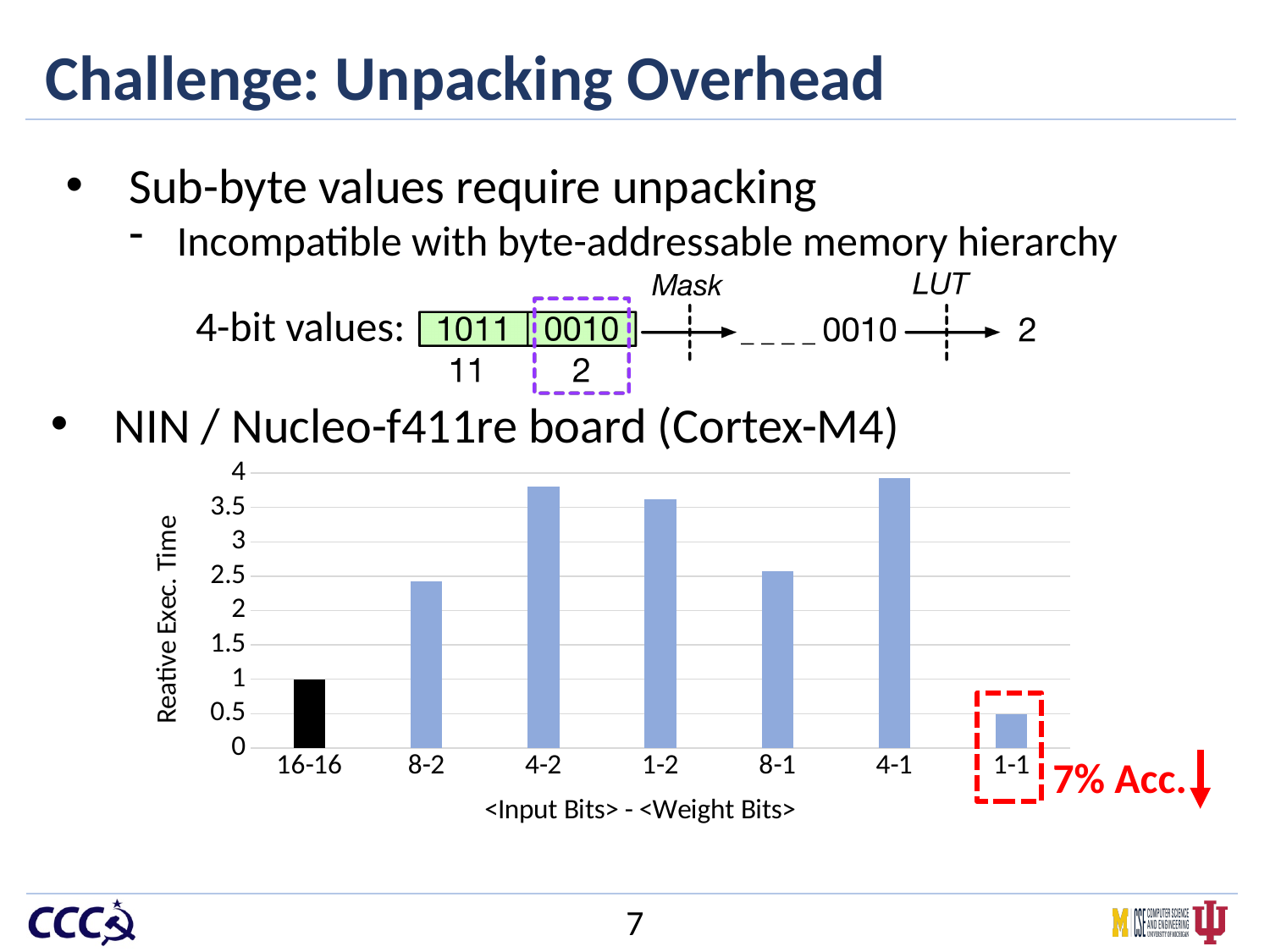
Is the value for 1-1 greater or less than 1? less Is the value for 8-2 greater or less than 2? greater Is the value for 8-1 greater or less than 3? less Which category has the lowest relative execution time? 1-1 Which category has the highest relative execution time? 4-1 What is the label on the y axis of the chart? Reative Exec. Time Which has a larger relative execution time, 1-2 or 8-1? 1-2 What is the label on the x axis of the chart? <Input Bits> - <Weight Bits> What kind of chart is shown on the slide? bar chart What is the relative execution time for 16-16? 1 How many categories are shown on the x axis of the chart? 7